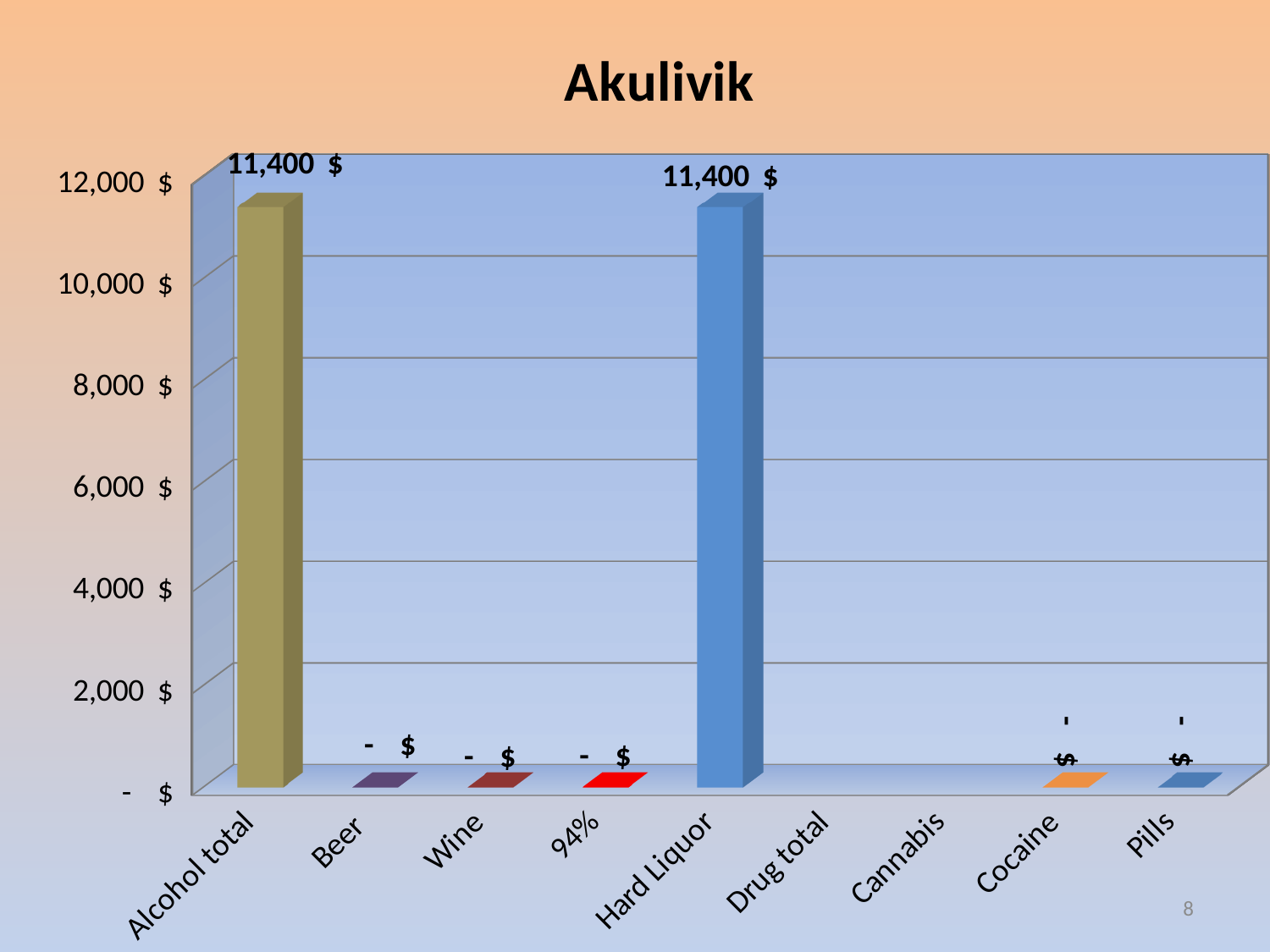
What value is shown for Cocaine? - $ How many categories are shown on the x axis? 9 What is the title of the chart? Akulivik What colour is the Hard Liquor bar? Blue Is the value for Alcohol total greater or less than 12,000 $? less What is the difference between the values for Alcohol total and Hard Liquor? 0 $ Which is larger, the value for Hard Liquor or the value for Wine? Hard Liquor What is the value for Hard Liquor? 11,400 $ What value is shown for Beer? - $ What kind of chart is shown on the slide? Bar chart Is the value for Hard Liquor greater or less than 10,000 $? greater What is the value for Alcohol total? 11,400 $